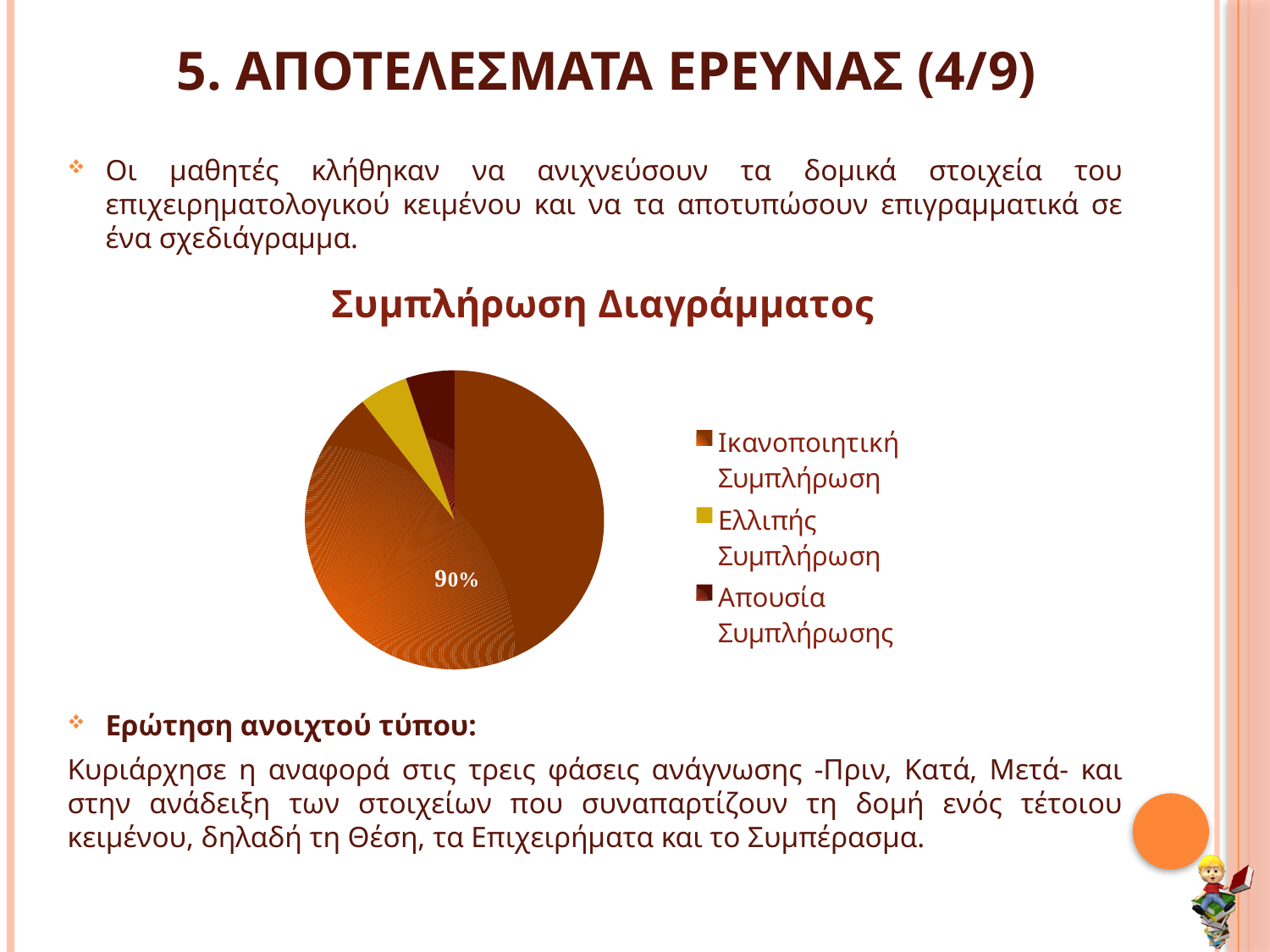
How many slices does the pie chart have? 3 Which is larger, Ικανοποιητική Συμπλήρωση or Απουσία Συμπλήρωσης? Ικανοποιητική Συμπλήρωση What kind of chart is shown on the slide? pie chart What percentage is shown for Ικανοποιητική Συμπλήρωση? 90% What share of the pie does Ικανοποιητική Συμπλήρωση take? 90% Which category has the largest share of the pie? Ικανοποιητική Συμπλήρωση Which is larger, Ικανοποιητική Συμπλήρωση or Ελλιπής Συμπλήρωση? Ικανοποιητική Συμπλήρωση How many entries does the legend list? 3 What is the title of the chart? Συμπλήρωση Διαγράμματος Which colour represents Ελλιπής Συμπλήρωση in the pie chart? yellow